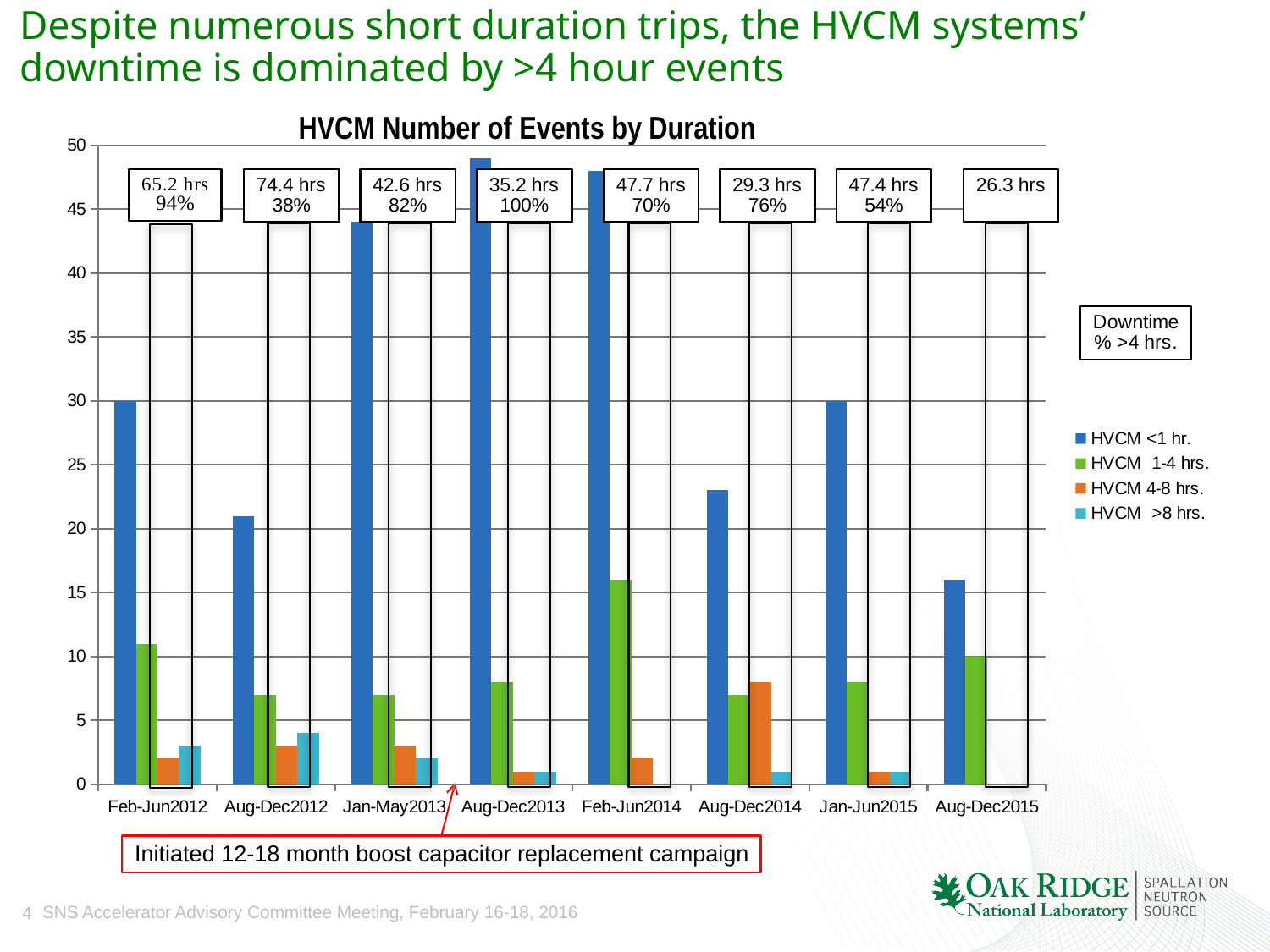
What is the value for HVCM 1-4 hrs. in Aug-Dec2015? 10 Which period has the lowest value for HVCM <1 hr.? Aug-Dec2015 What is the value for HVCM <1 hr. in Jan-Jun2015? 30 In Aug-Dec2014, which is larger: HVCM 4-8 hrs. or HVCM >8 hrs.? HVCM 4-8 hrs. Is the value for HVCM <1 hr. in Feb-Jun2014 greater or less than 45? greater Which period has the highest value for HVCM 1-4 hrs.? Feb-Jun2014 Is the value for HVCM <1 hr. in Aug-Dec2014 greater or less than 25? less What is the title of the chart? HVCM Number of Events by Duration How many time periods are shown on the x axis? 8 What is the value for HVCM <1 hr. in Feb-Jun2012? 30 What kind of chart is shown on the slide? Bar chart How many series does the legend list? 4